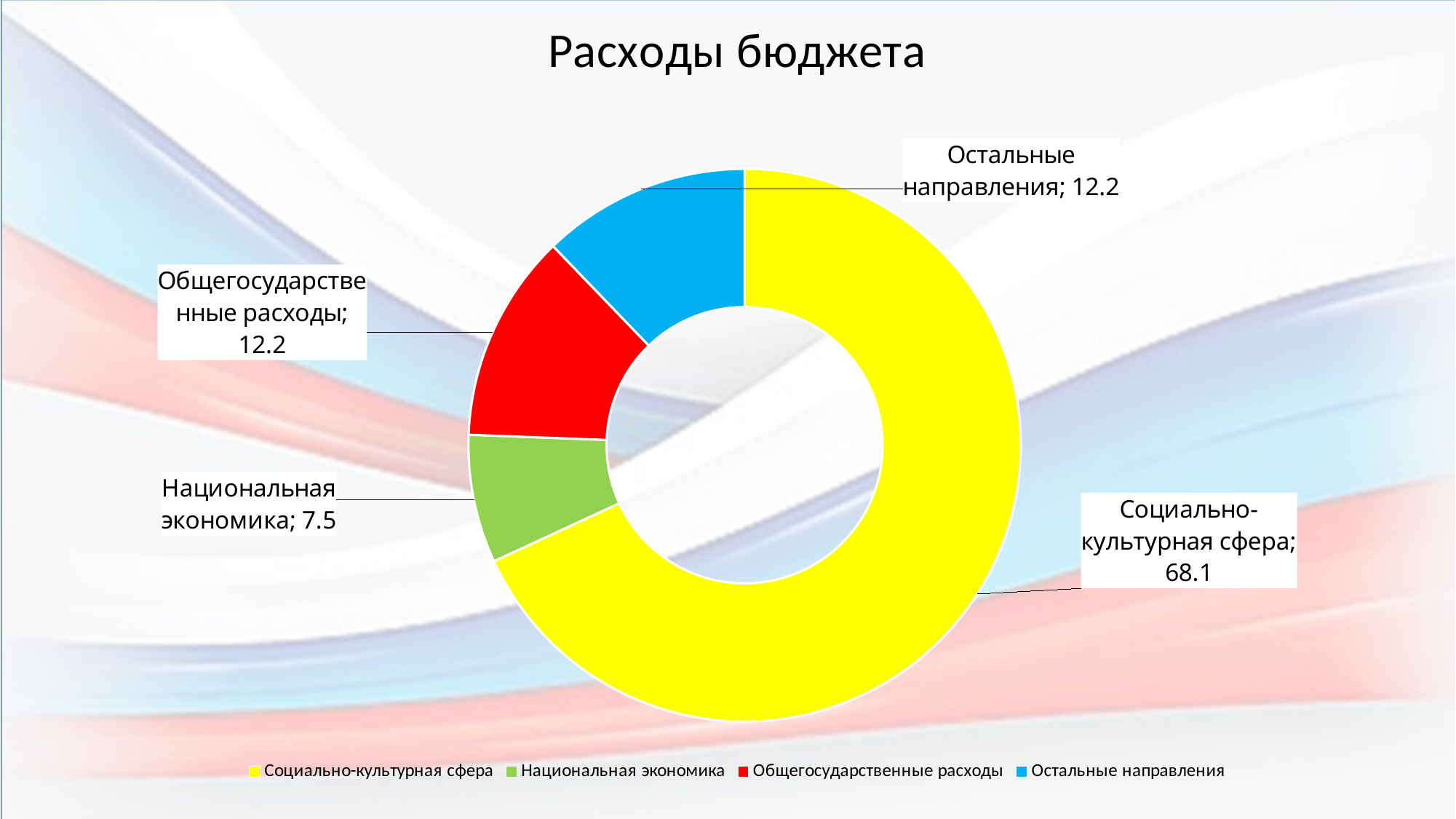
What is the difference between the values for Общегосударственные расходы and Национальная экономика? 4.7 What is the value for Национальная экономика? 7.5 What kind of chart is shown on the slide? Doughnut chart What is the value for Общегосударственные расходы? 12.2 What is the value for Остальные направления? 12.2 Which is larger, the value for Социально-культурная сфера or the value for Остальные направления? Социально-культурная сфера Which category has the smallest value? Национальная экономика What is the difference between the values for Социально-культурная сфера and Национальная экономика? 60.6 How many categories are shown in the chart? 4 Which category has the largest value? Социально-культурная сфера What is the value for Социально-культурная сфера? 68.1 What is the title of the chart? Расходы бюджета